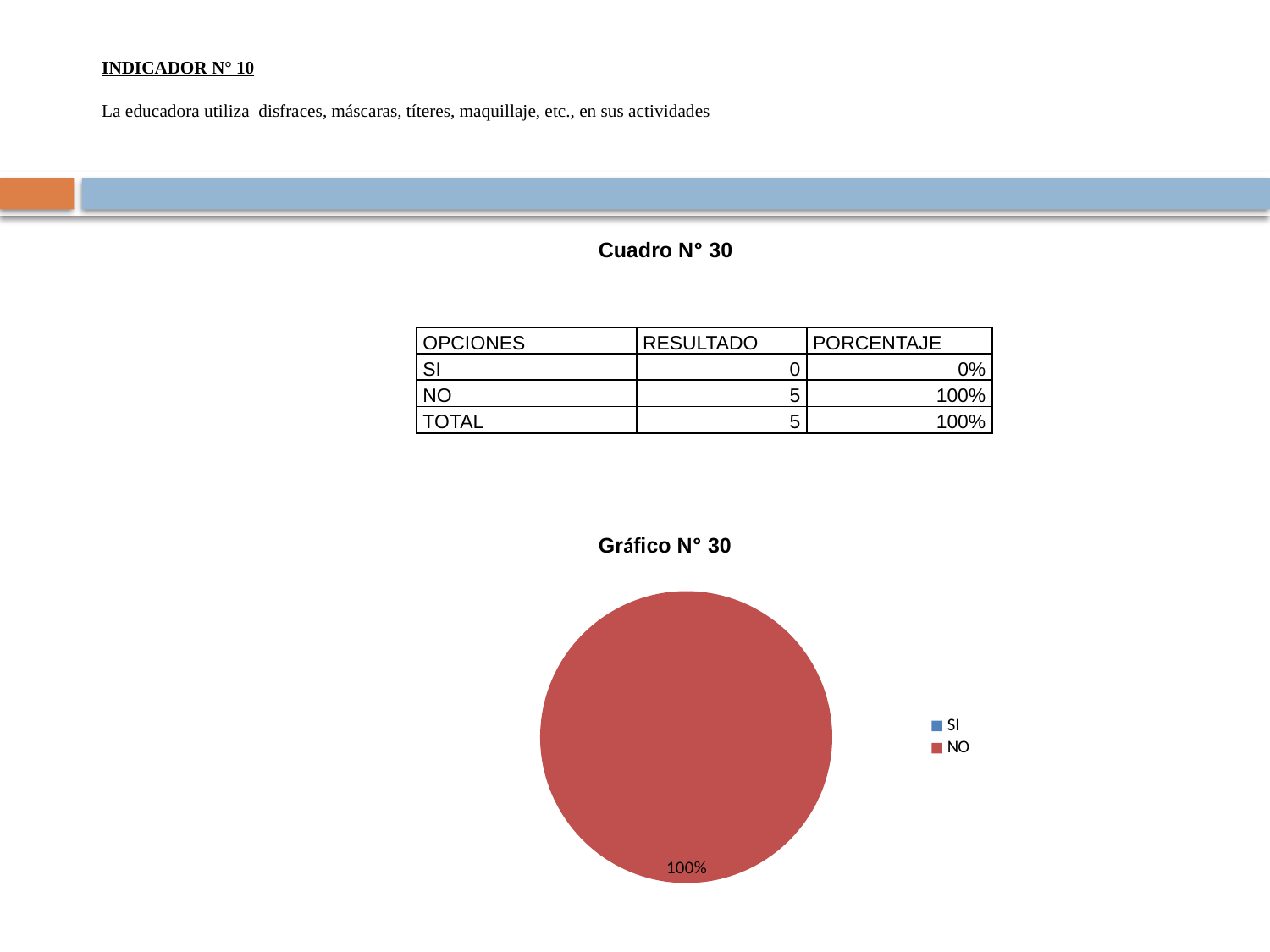
In Gráfico N° 30, which category has the smallest slice? SI What kind of chart is Gráfico N° 30? pie chart In Gráfico N° 30, what percentage label is printed on the pie? 100% What colour is the NO slice in Gráfico N° 30? red In Gráfico N° 30, which is larger, the slice for SI or the slice for NO? NO In Gráfico N° 30, which category has the largest slice? NO How many entries does the legend of Gráfico N° 30 list? 2 What is the title of the chart on the slide? Gráfico N° 30 In Gráfico N° 30, what share of the pie does NO take? 100%